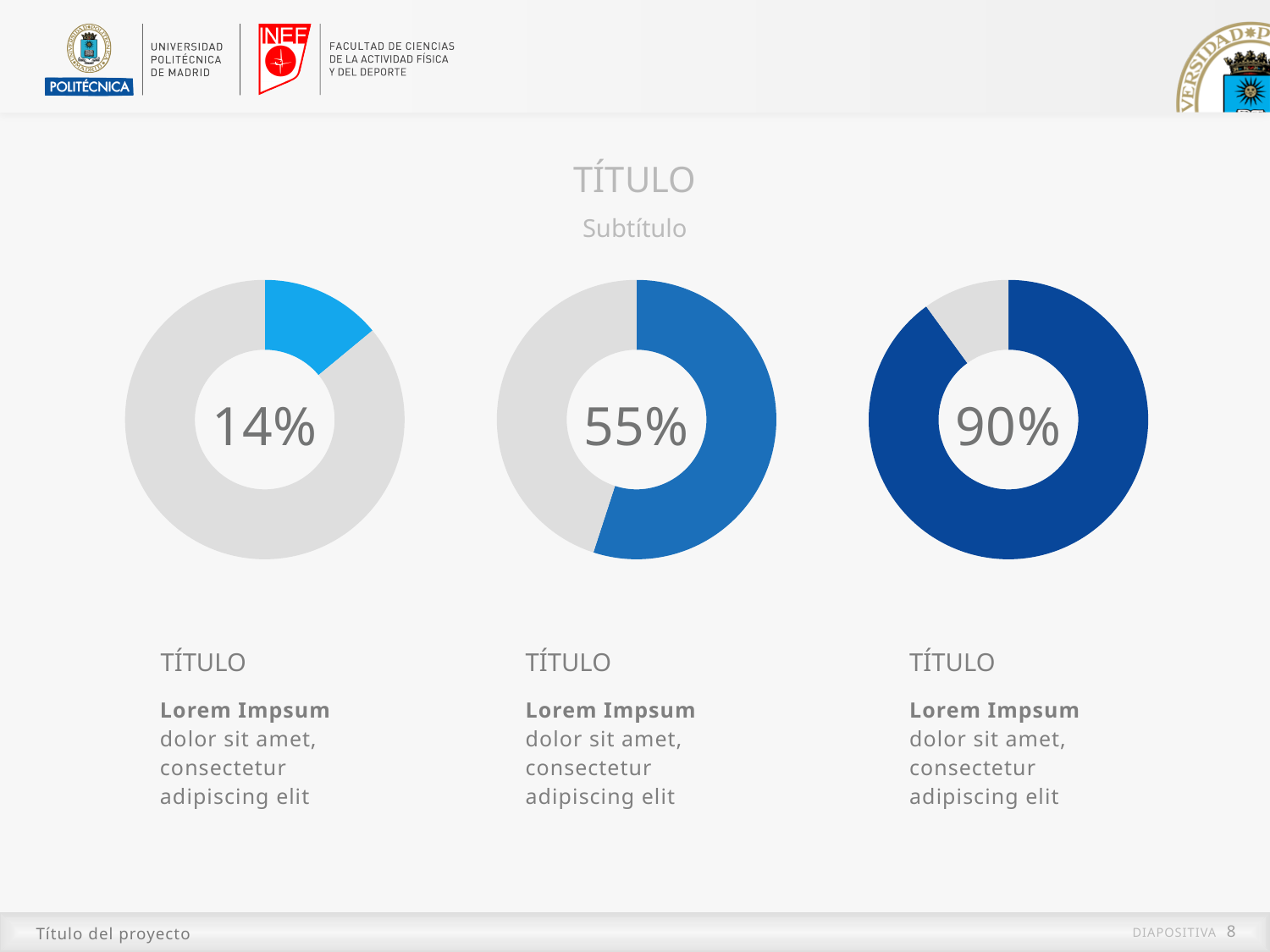
What percentage is shown in the centre of the right donut chart? 90% What is the difference between the percentage in the right donut chart and the percentage in the left donut chart? 76% How many donut charts are shown on the slide? 3 What is the difference between the percentage in the middle donut chart and the percentage in the left donut chart? 41% Which of the three donut charts shows the lowest percentage? The left chart (14%) What type of chart is used to display the three percentages on the slide? Donut (pie) chart What percentage is shown in the centre of the middle donut chart? 55% Is the percentage in the middle donut chart larger or smaller than the percentage in the right donut chart? Smaller Do the percentages increase or decrease when reading the donut charts from left to right? Increase What is the title shown above the three donut charts? TÍTULO Which of the three donut charts shows the highest percentage? The right chart (90%) What percentage is shown in the centre of the left donut chart? 14%